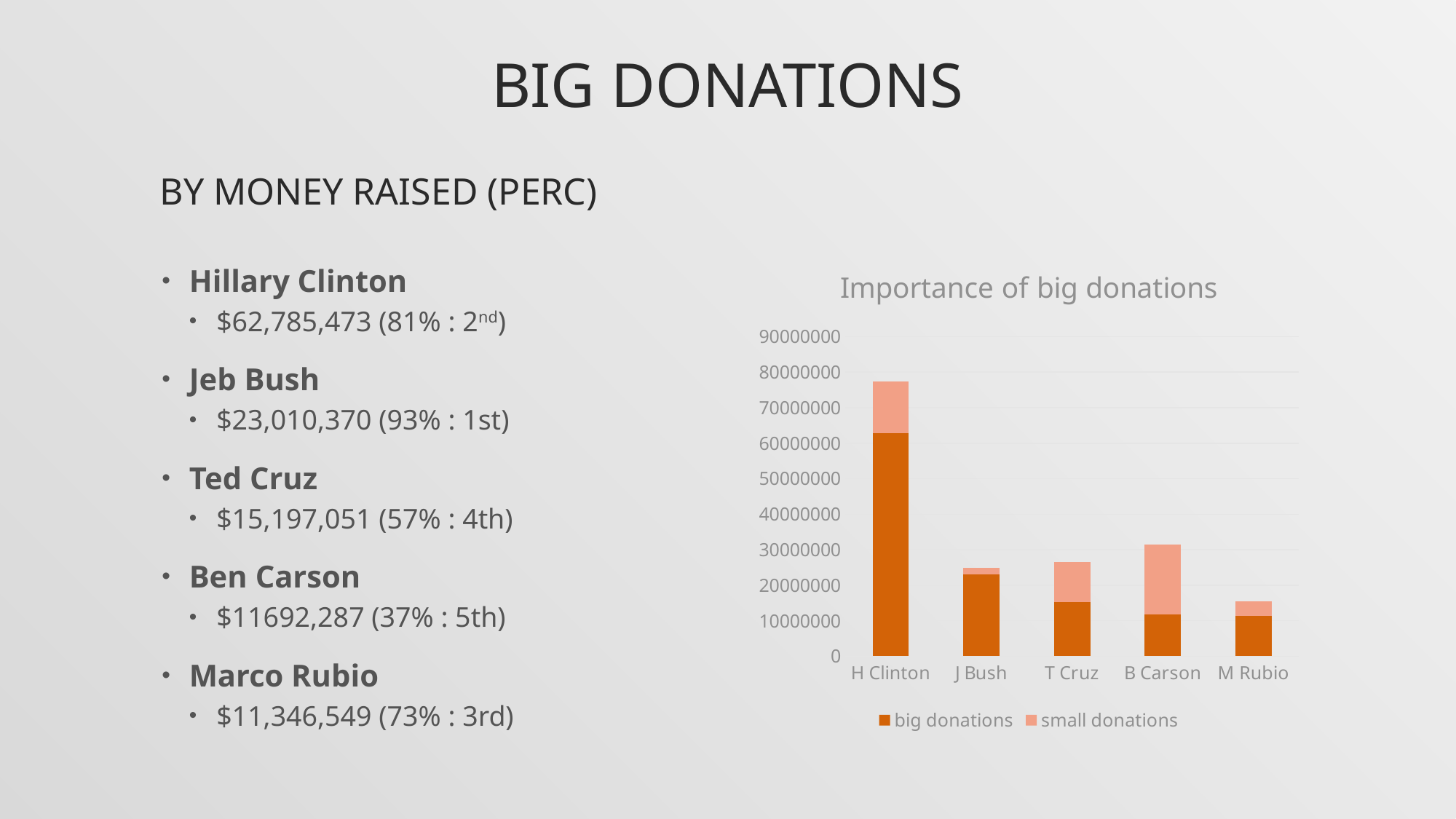
How many series does the chart legend list? 2 Which is larger in the chart, the big donations value for H Clinton or for J Bush? H Clinton Which candidate has the shortest total bar in the chart? M Rubio Is the total bar for B Carson greater or less than 30000000? greater What is the title of the chart? Importance of big donations What kind of chart is shown on the slide? stacked bar chart Which candidate has the tallest total bar in the chart? H Clinton Which series is shown in the darker orange colour in the chart? big donations Is the total bar for H Clinton greater or less than 70000000? greater Is the big donations value for J Bush greater or less than 30000000? less Which candidate has the larger small donations segment, B Carson or J Bush? B Carson How many candidates are shown on the x axis of the chart? 5